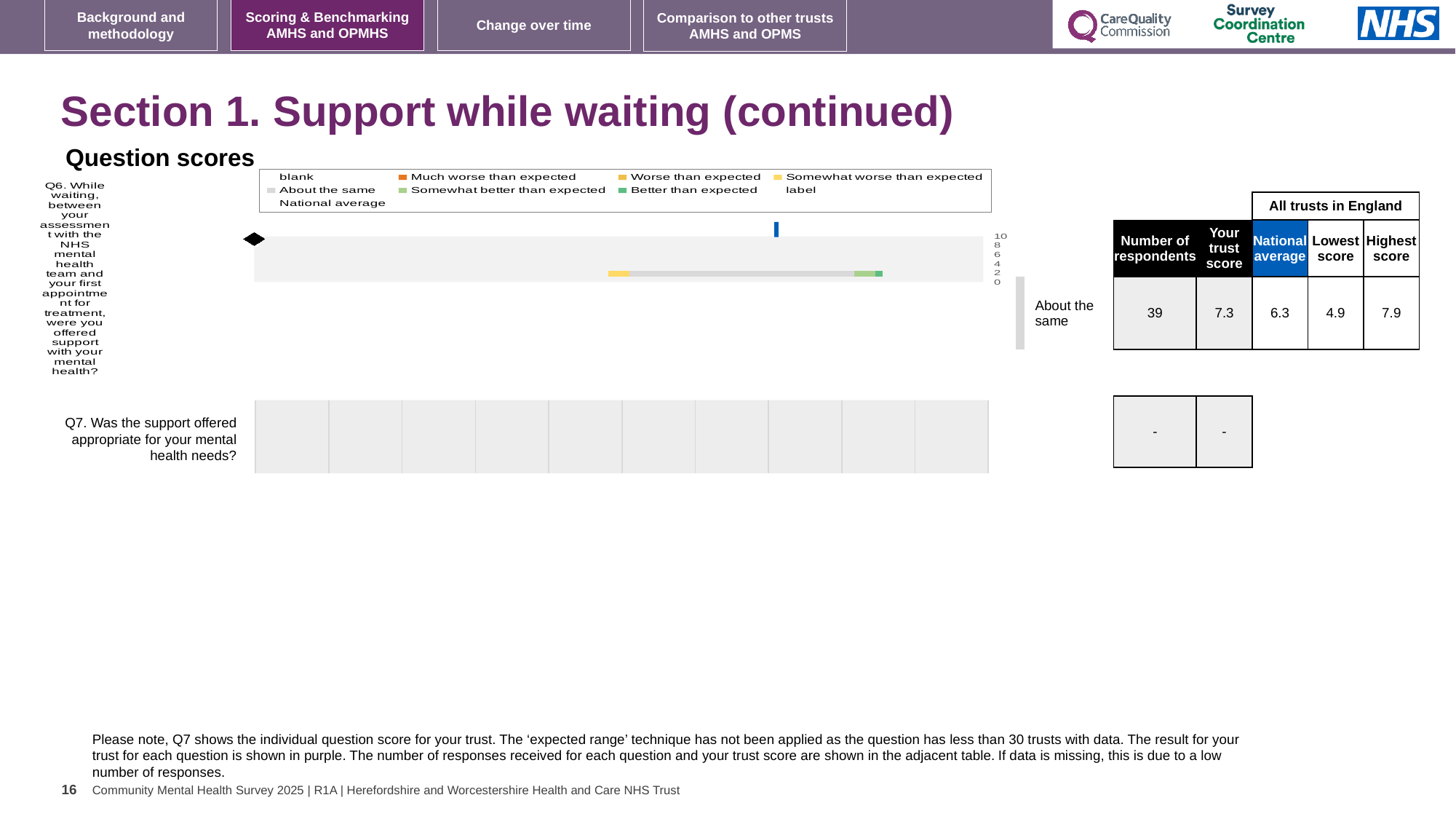
What is the highest score among all trusts in England for Q6? 7.9 What category label is shown next to the Q6 bar in the chart? About the same For Q6, which is larger: the trust score or the national average? the trust score What is the trust score shown for Q7 (was the support offered appropriate for your mental health needs)? - What is the lowest score among all trusts in England for Q6? 4.9 What is the difference between the trust score and the national average for Q6? 1.0 What kind of chart is used to show the question scores on this slide? bar chart What is the trust score for Q6 (support with your mental health while waiting)? 7.3 What is the national average score for Q6? 6.3 How many respondents answered Q6? 39 What is the difference between the highest and lowest scores for Q6 across all trusts in England? 3.0